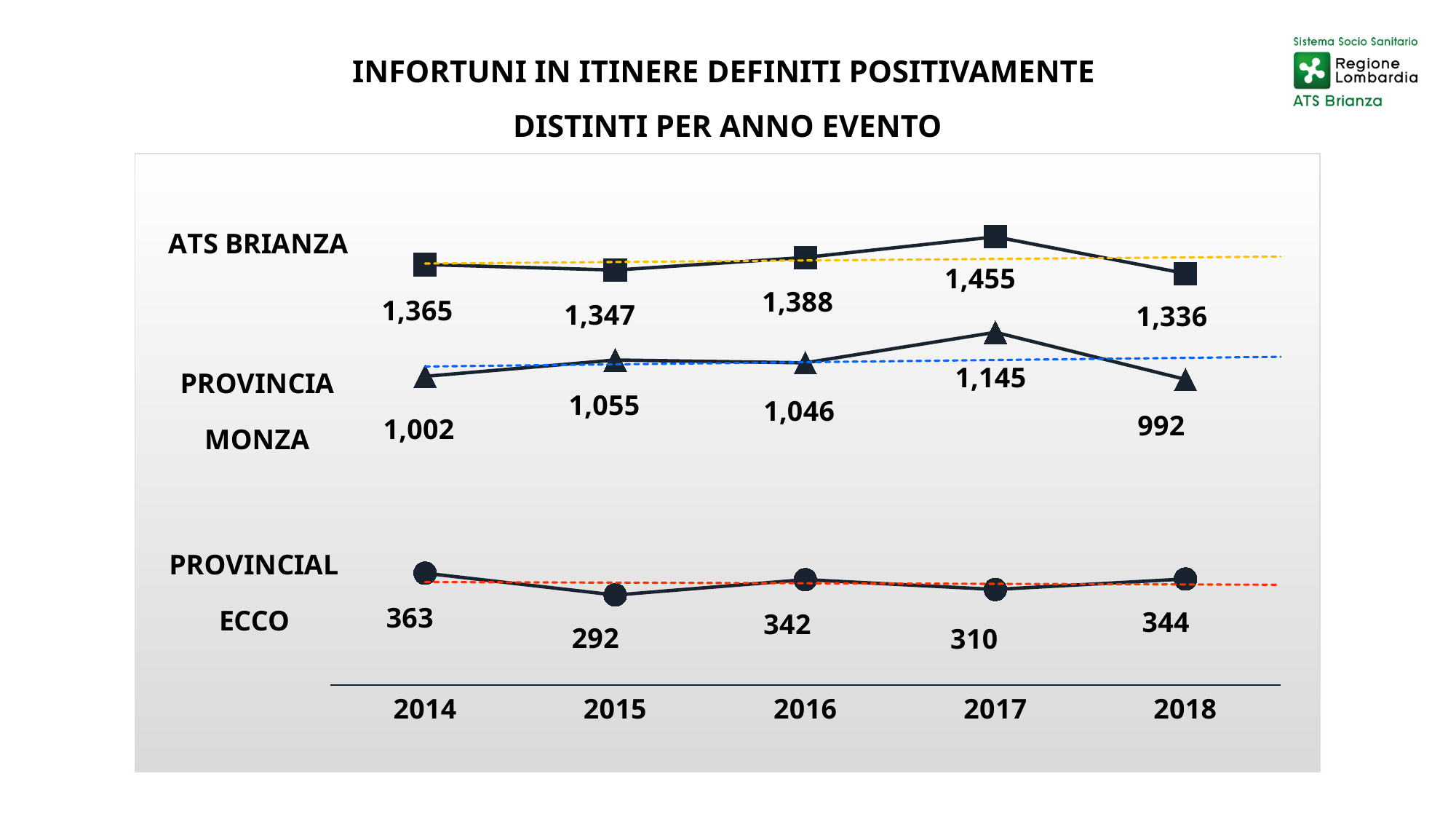
What is the value for ATS BRIANZA in 2017? 1,455 What is the difference between the ATS BRIANZA values for 2017 and 2018? 119 In which year is the PROVINCIAL ECCO series at its lowest value? 2015 How many data series are plotted on the chart? 3 What is the value for the PROVINCIAL ECCO series in 2015? 292 Which is larger for PROVINCIA MONZA: the 2016 value or the 2018 value? 2016 What is the difference between the PROVINCIA MONZA values for 2015 and 2014? 53 What kind of chart is shown on the slide? Line chart How many years are shown on the x axis? 5 In which year does ATS BRIANZA reach its highest value? 2017 What is the value for PROVINCIA MONZA in 2018? 992 Does the ATS BRIANZA series rise or fall from 2017 to 2018? Fall